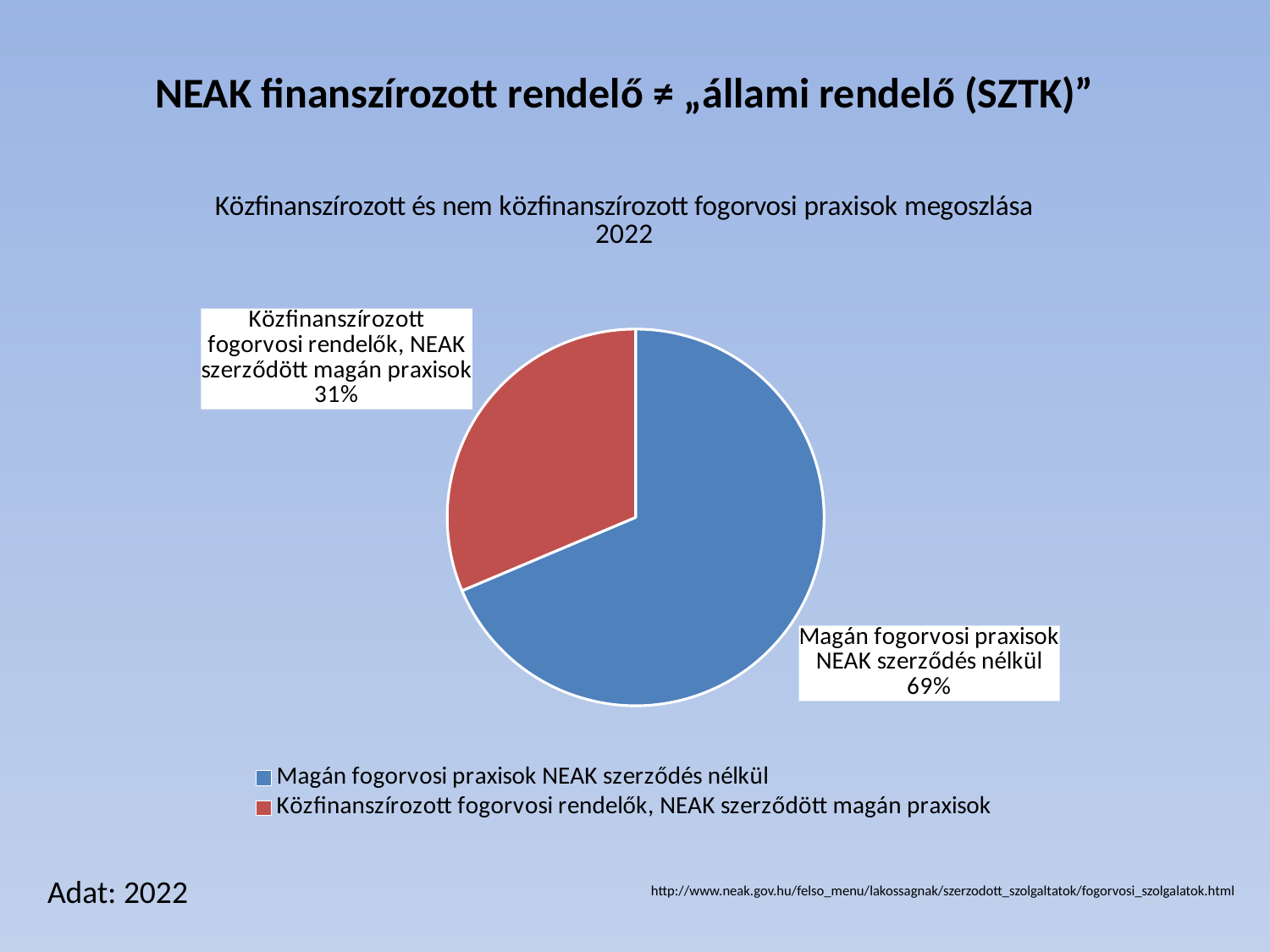
What is the title of the pie chart? Közfinanszírozott és nem közfinanszírozott fogorvosi praxisok megoszlása 2022 What is the difference in percentage points between the "Magán fogorvosi praxisok NEAK szerződés nélkül" slice and the "Közfinanszírozott fogorvosi rendelők, NEAK szerződött magán praxisok" slice? 38 percentage points Which slice of the pie is the smallest? Közfinanszírozott fogorvosi rendelők, NEAK szerződött magán praxisok Which slice of the pie is the largest? Magán fogorvosi praxisok NEAK szerződés nélkül How many entries does the legend list? 2 How many slices does the pie chart have? 2 What share of the pie does "Közfinanszírozott fogorvosi rendelők, NEAK szerződött magán praxisok" represent? 31% What colour is the slice for "Közfinanszírozott fogorvosi rendelők, NEAK szerződött magán praxisok"? Red What share of the pie does "Magán fogorvosi praxisok NEAK szerződés nélkül" represent? 69% What kind of chart is shown on the slide? Pie chart Which is larger: the share of "Magán fogorvosi praxisok NEAK szerződés nélkül" or the share of "Közfinanszírozott fogorvosi rendelők, NEAK szerződött magán praxisok"? Magán fogorvosi praxisok NEAK szerződés nélkül